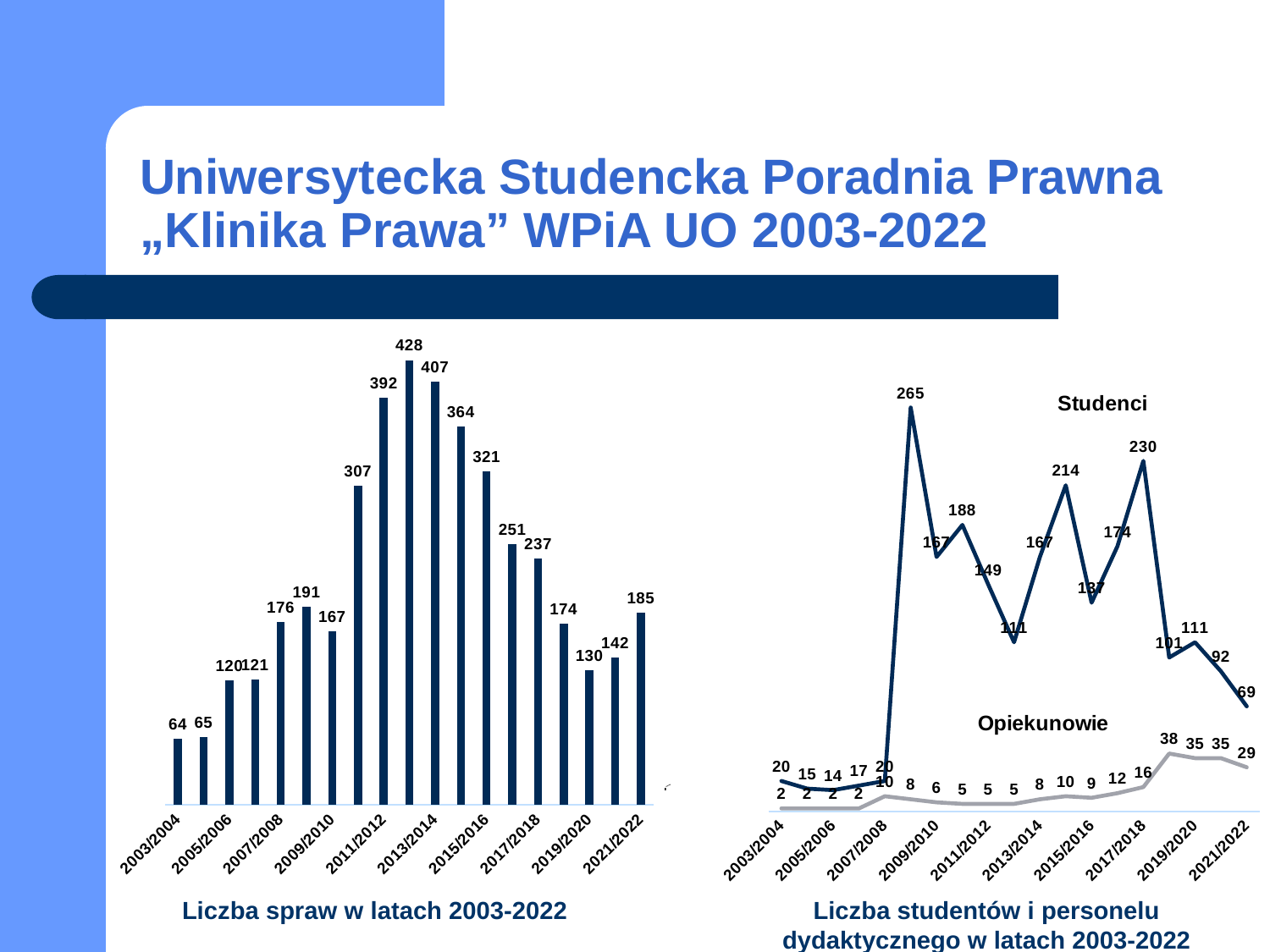
How many bars are plotted in the left chart 'Liczba spraw w latach 2003-2022'? 19 In the right chart 'Liczba studentów i personelu dydaktycznego w latach 2003-2022', what is the value for Opiekunowie in 2021/2022? 29 In the left chart 'Liczba spraw w latach 2003-2022', what is the value for 2003/2004? 64 In the left chart 'Liczba spraw w latach 2003-2022', what is the highest value shown? 428 In the left chart 'Liczba spraw w latach 2003-2022', what is the value for 2021/2022? 185 In the left chart 'Liczba spraw w latach 2003-2022', which is larger, the value for 2013/2014 or the value for 2017/2018? 2013/2014 What kind of chart is the left chart, 'Liczba spraw w latach 2003-2022'? bar chart In the right chart 'Liczba studentów i personelu dydaktycznego w latach 2003-2022', what is the highest value for Studenci? 265 In the right chart 'Liczba studentów i personelu dydaktycznego w latach 2003-2022', what is the difference between Studenci and Opiekunowie in 2021/2022? 40 In the right chart 'Liczba studentów i personelu dydaktycznego w latach 2003-2022', what is the value for Studenci in 2017/2018? 230 In the left chart 'Liczba spraw w latach 2003-2022', what is the difference between the values for 2021/2022 and 2019/2020? 55 How many series are shown in the right chart 'Liczba studentów i personelu dydaktycznego w latach 2003-2022'? 2